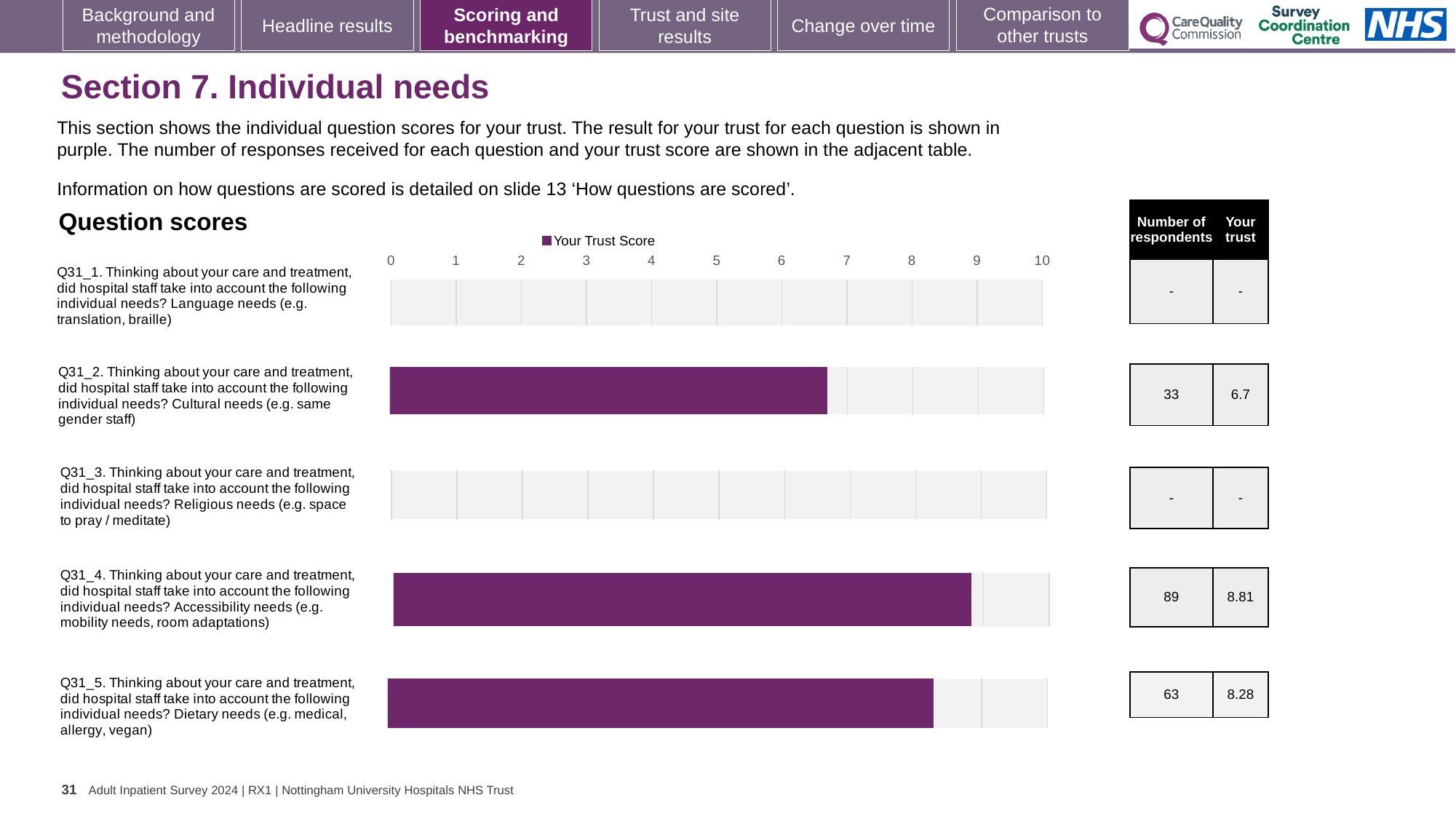
What is the trust score for Q31_4 (Accessibility needs)? 8.81 How many questions are listed in the chart? 5 What is the trust score for Q31_2 (Cultural needs)? 6.7 Which question has the highest trust score? Q31_4 (Accessibility needs) What is the difference between the trust scores for Q31_4 and Q31_5? 0.53 Among the questions with a plotted score, which has the lowest trust score? Q31_2 (Cultural needs) How many respondents answered Q31_2 (Cultural needs)? 33 Which has a higher trust score, Q31_2 or Q31_5? Q31_5 What kind of chart is used to show the question scores? Bar chart How many respondents answered Q31_4 (Accessibility needs)? 89 What is the trust score for Q31_5 (Dietary needs)? 8.28 Is the trust score for Q31_2 greater or less than 7? less